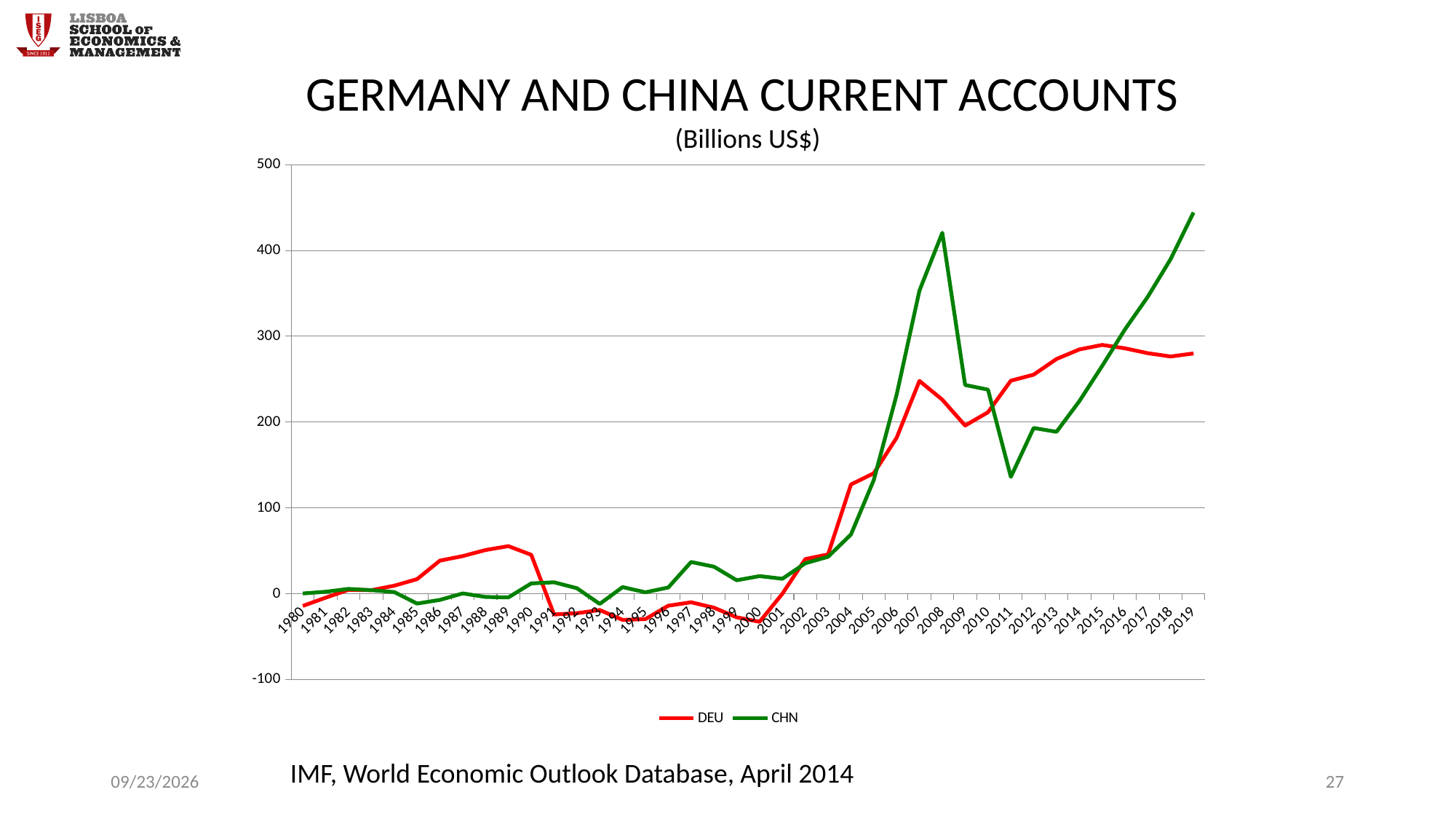
How many series does the legend list? 2 How many years are plotted along the x axis? 40 Is the value for CHN in 2008 greater or less than 400? greater What unit is given in the chart's subtitle? Billions US$ Is the value for DEU in 2007 greater or less than 200? greater Is the value for CHN in 2011 greater or less than 150? less What kind of chart is shown on the slide? line chart In which year does the CHN series reach its highest value? 2019 In 2011, which series has the larger value, DEU or CHN? DEU In 2019, which series has the larger value, DEU or CHN? CHN Does the CHN series rise or fall from 2011 to 2019? rise